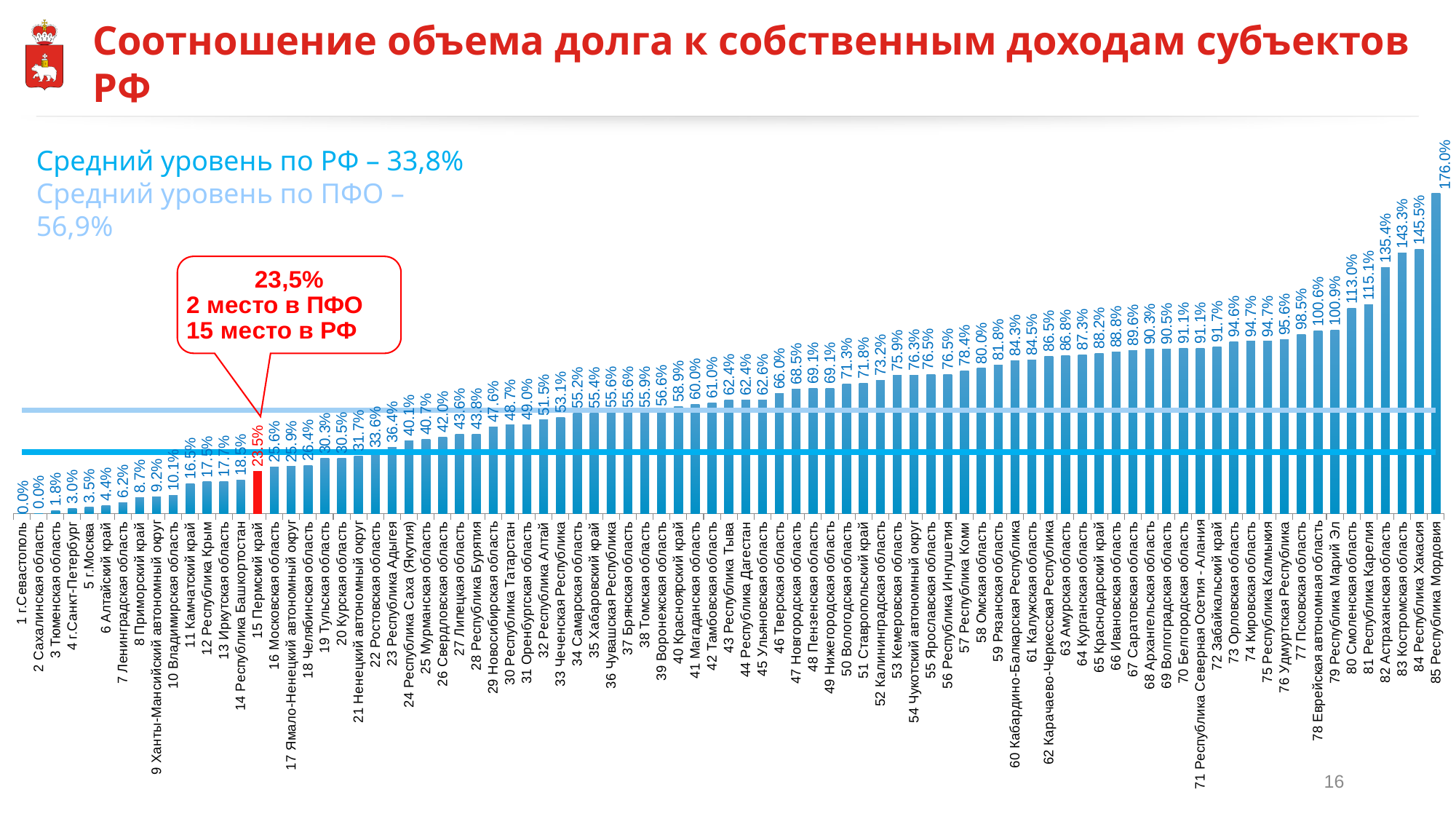
Which region has the highest value on the chart? Республика Мордовия What is the value for Республика Хакасия? 145,5% What is the value for Республика Татарстан? 48,7% Which has a larger value, Московская область or Челябинская область? Челябинская область What place does Пермский край hold in the ПФО according to the callout? 2 место Do the values rise or fall from left to right along the x axis? rise What is the average level for the Russian Federation (РФ) stated on the slide? 33,8% What is the difference between the values for Республика Мордовия and Республика Хакасия? 30,5% What is the value for Республика Мордовия? 176,0% What type of chart is shown on the slide? bar chart What is the value for Пермский край? 23,5% What is the difference between the values for Пермский край and Республика Башкортостан? 5,0%